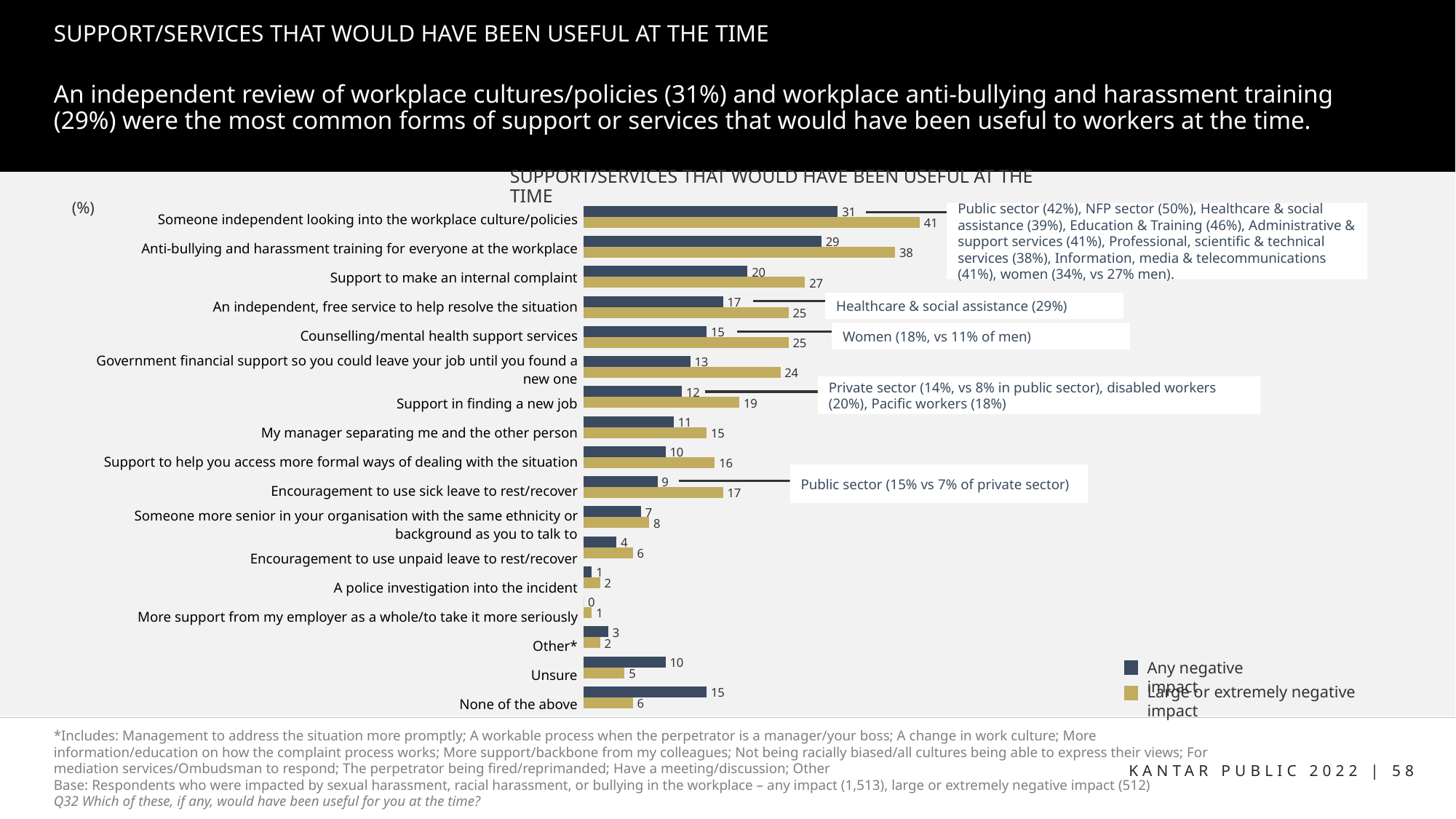
What is the value for 'Any negative impact' for 'Someone independent looking into the workplace culture/policies'? 31 Which category has the highest value for 'Large or extremely negative impact'? Someone independent looking into the workplace culture/policies What kind of chart is shown on the slide? Bar chart Which colour represents the 'Large or extremely negative impact' series? Gold What is the difference between the 'Large or extremely negative impact' and 'Any negative impact' values for 'Support to make an internal complaint'? 7 How many categories are shown on the chart? 17 For 'None of the above', which series has the larger value: 'Any negative impact' or 'Large or extremely negative impact'? Any negative impact How many series does the legend list? 2 What is the value for 'Any negative impact' for 'Unsure'? 10 What is the value for 'Large or extremely negative impact' for 'Anti-bullying and harassment training for everyone at the workplace'? 38 Which category has the lowest value for 'Any negative impact'? More support from my employer as a whole/to take it more seriously What is the value for 'Large or extremely negative impact' for 'Encouragement to use sick leave to rest/recover'? 17